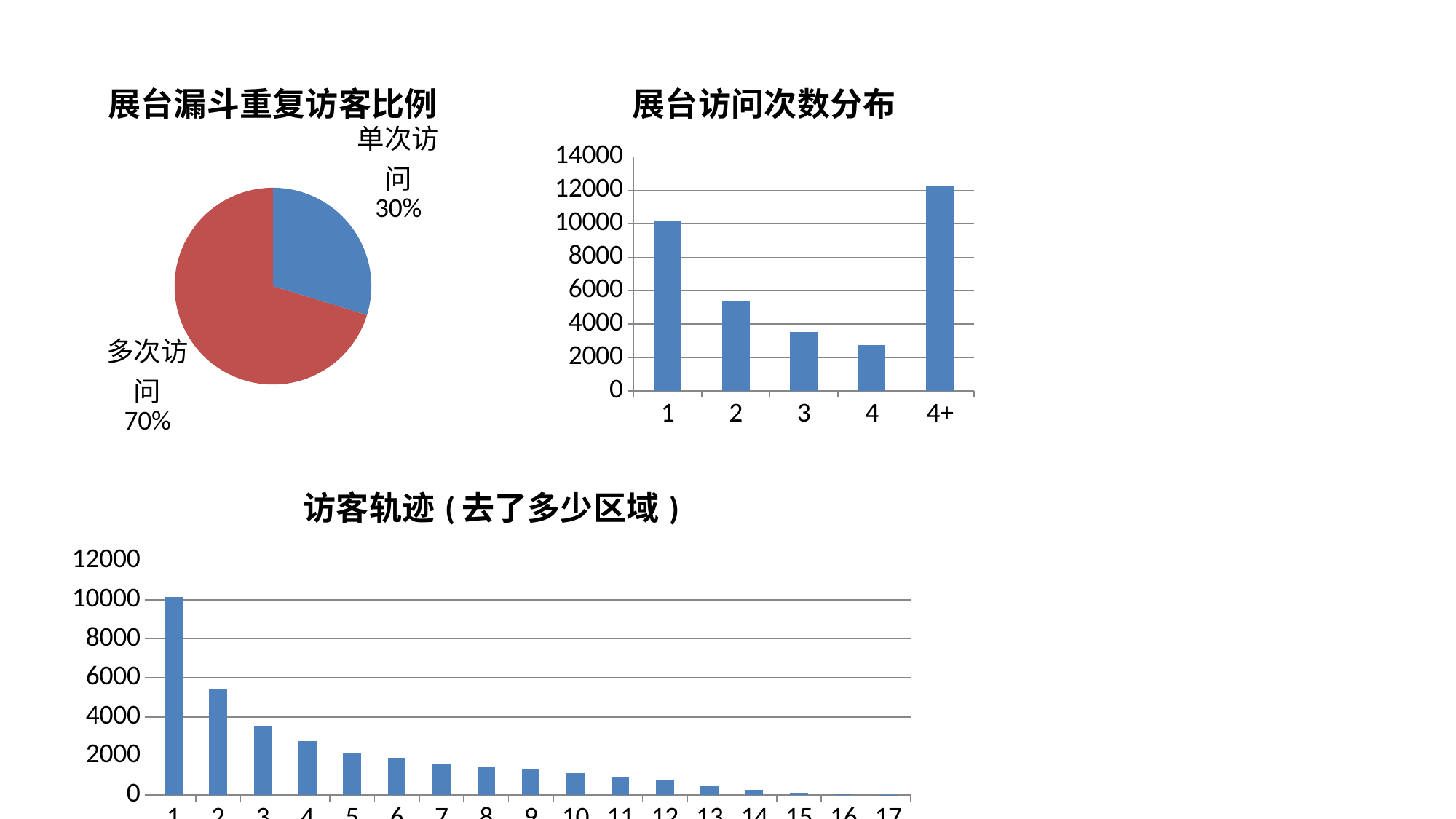
In the chart 展台访问次数分布, is the value for category 1 greater or less than 8000? greater In the chart 访客轨迹（去了多少区域）, do the values rise or fall as you move from category 1 to category 17? fall How many categories are shown on the x axis of the chart 访客轨迹（去了多少区域）? 17 In the chart 访客轨迹（去了多少区域）, is the value for category 2 greater or less than 4000? greater How many slices does the pie chart 展台漏斗重复访客比例 have? 2 In the pie chart 展台漏斗重复访客比例, what percentage is shown for 多次访问? 70% In the chart 展台访问次数分布, which category has the lowest value? 4 What kind of chart is 展台访问次数分布? bar chart In the chart 展台访问次数分布, is the value for category 3 greater or less than 4000? less In the pie chart 展台漏斗重复访客比例, which slice is larger, 单次访问 or 多次访问? 多次访问 In the chart 展台访问次数分布, which category has the highest value? 4+ In the pie chart 展台漏斗重复访客比例, what share of the pie does 单次访问 take? 30%